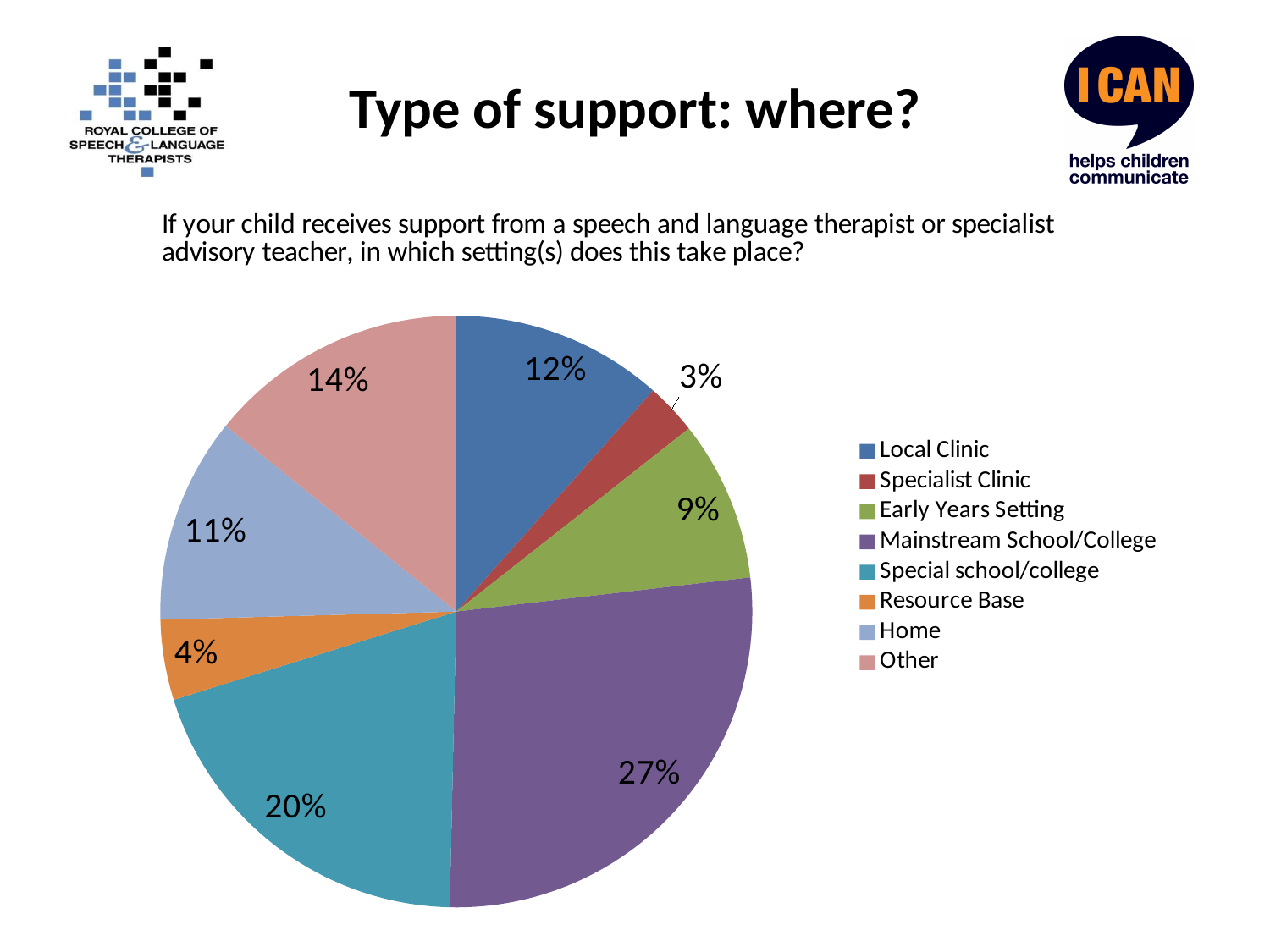
What kind of chart is shown on the slide? pie chart Which is larger, the share for Home or the share for Other? Other Which setting has the largest share of the pie? Mainstream School/College What percentage of the pie is Mainstream School/College? 27% What is the difference in percentage points between Early Years Setting and Specialist Clinic? 6 How many categories does the legend list? 8 What percentage of the pie is Resource Base? 4% What percentage of the pie is Local Clinic? 12% What percentage of the pie is Special school/college? 20% What is the title of the slide containing the chart? Type of support: where? What is the difference in percentage points between Mainstream School/College and Special school/college? 7 Which setting has the smallest share of the pie? Specialist Clinic